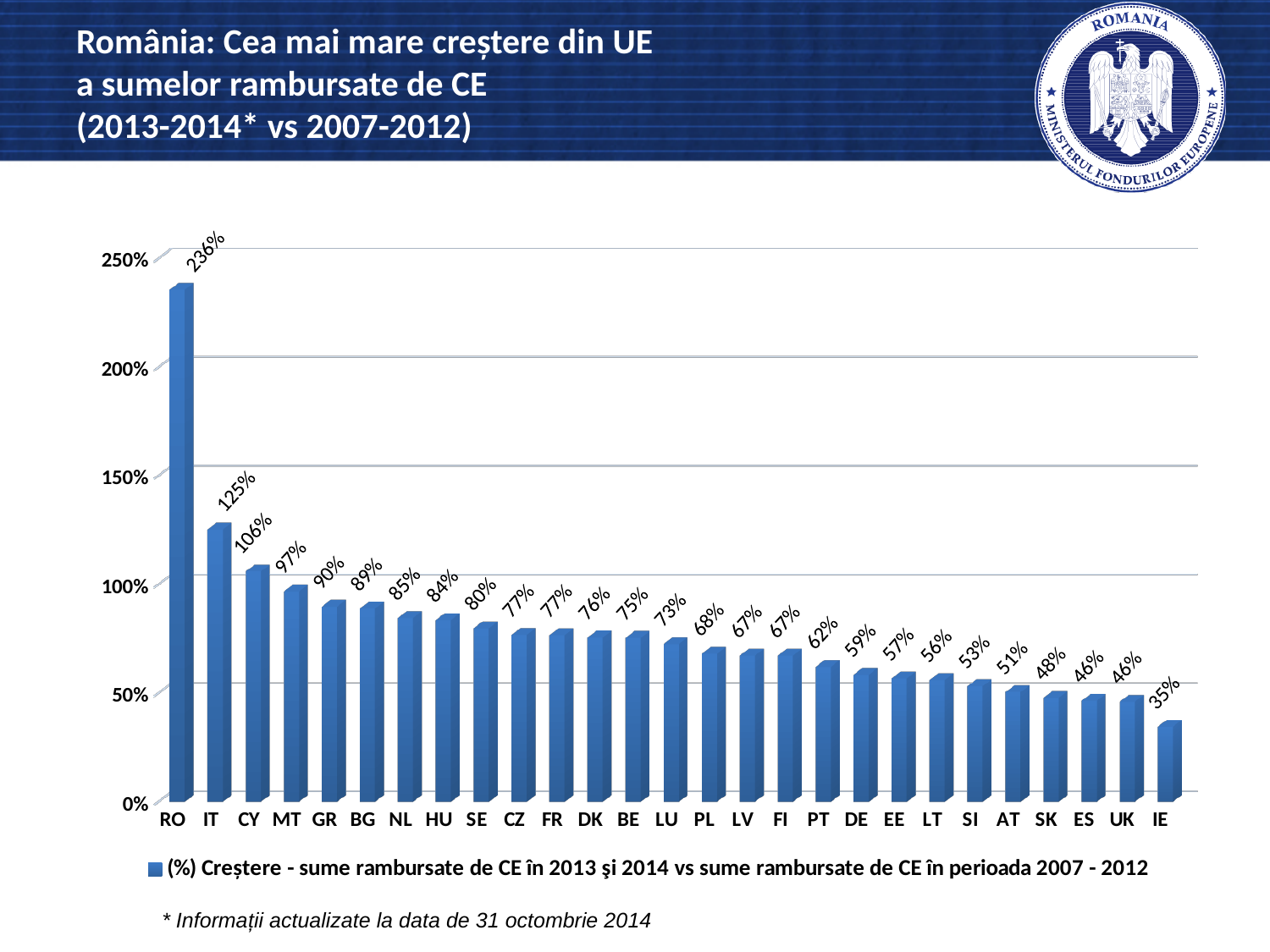
What is the difference between the values for MT and IE? 62% What kind of chart is shown on the slide? bar chart Do the values rise or fall from left to right along the x axis? fall What is the value for RO? 236% Which is larger, the value for CY or the value for GR? CY Which country has the highest value? RO What is the value for DE? 59% What is the value for PL? 68% Which country has the lowest value? IE Is the value for IT greater or less than 100%? greater How many countries are shown on the x axis? 27 What is the difference between the values for RO and IT? 111%